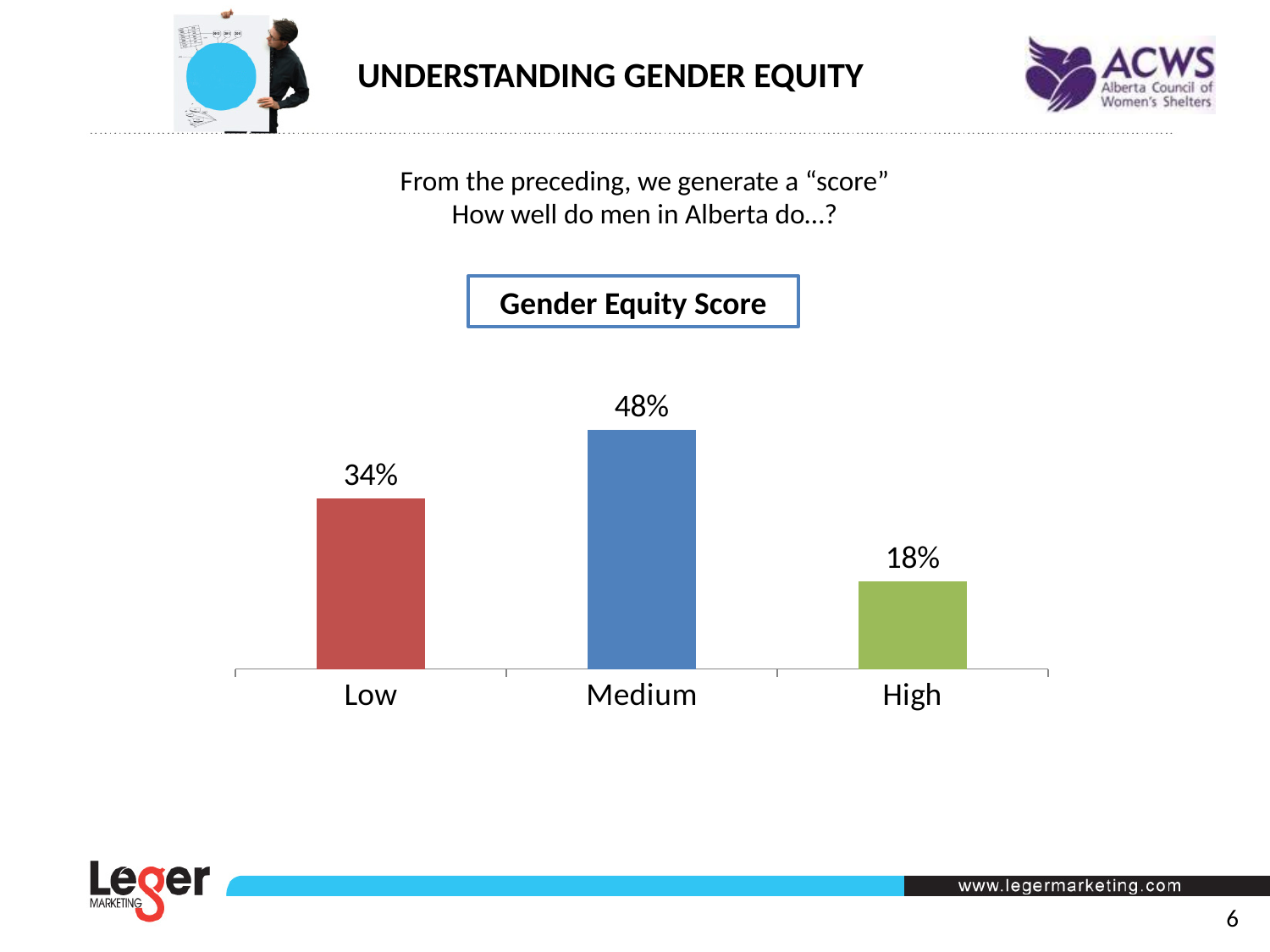
What colour is the bar for the Medium category? Blue Which is larger, the value for Low or the value for High? Low Which category has the highest value? Medium What is the value for the Low category? 34% What is the difference between the Low and High values? 16% Which category has the lowest value? High What is the value for the High category? 18% What is the difference between the Medium and Low values? 14% How many categories are shown on the chart? 3 What is the title shown above the chart? Gender Equity Score What is the value for the Medium category? 48% What kind of chart is shown on the slide? Bar chart